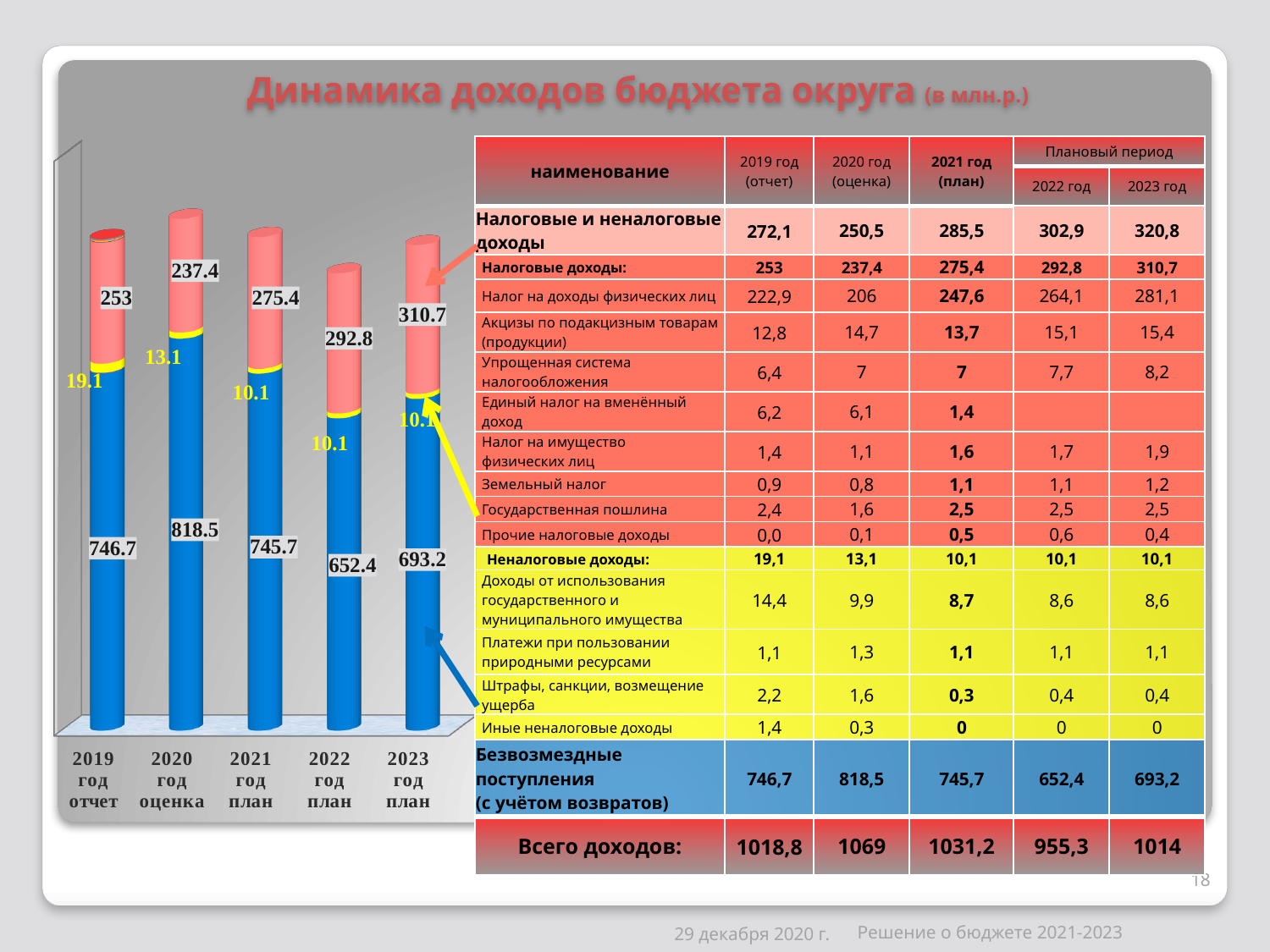
What is the difference between the blue segment values for 2020 год оценка and 2022 год план? 166.1 How many bars (years) are shown in the chart? 5 What is the total of the stacked bar for 2022 год план? 955.3 What is the value of the blue (bottom) segment of the bar for 2020 год оценка? 818.5 Which year has the largest blue (bottom) segment? 2020 год оценка What is the value of the yellow (middle) segment of the bar for 2019 год отчет? 19.1 Which year has the smallest blue (bottom) segment? 2022 год план What is the value of the pink (top) segment of the bar for 2023 год план? 310.7 Which year has the largest pink (top) segment? 2023 год план Which is larger: the pink segment for 2019 год отчет or for 2020 год оценка? 2019 год отчет Does the pink (top) segment rise or fall from 2021 год план to 2023 год план? Rise What kind of chart is shown on the slide? Stacked bar chart